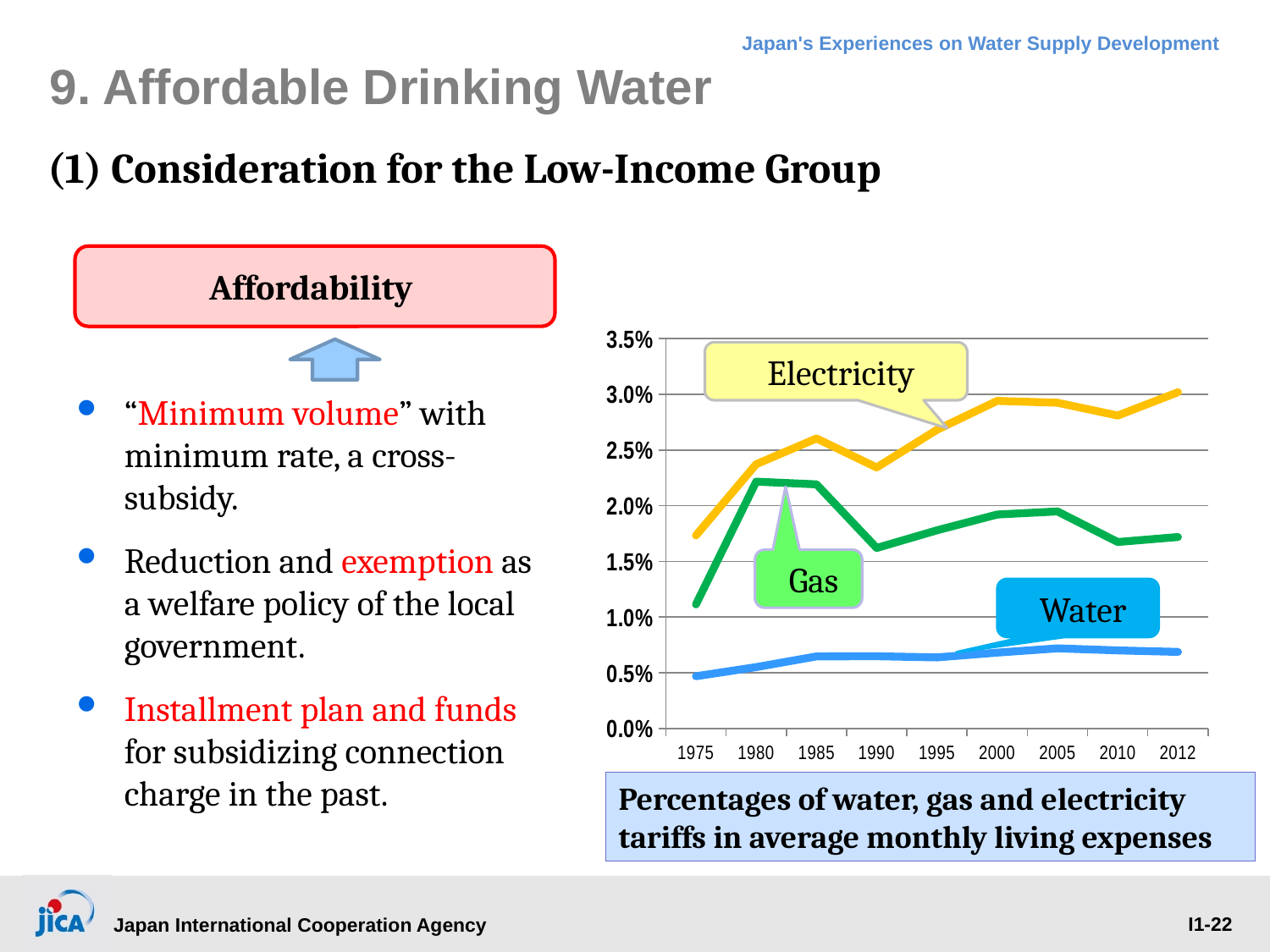
Which is larger in 2005, the value for Electricity or the value for Gas? Electricity Is the value for Electricity in 2012 greater or less than 2.5%? greater How many series are plotted on the chart? 3 Does the Electricity series overall rise or fall from 1975 to 2012? rise Is the value for Gas in 1975 greater or less than 1.5%? less Is the value for Water in 2005 greater or less than 1.0%? less Which series has the lowest values across all years shown? Water What kind of chart is shown on the slide? line chart How many years are marked on the x axis of the chart? 9 Which series has the highest value in 2012? Electricity What is the caption shown below the chart? Percentages of water, gas and electricity tariffs in average monthly living expenses